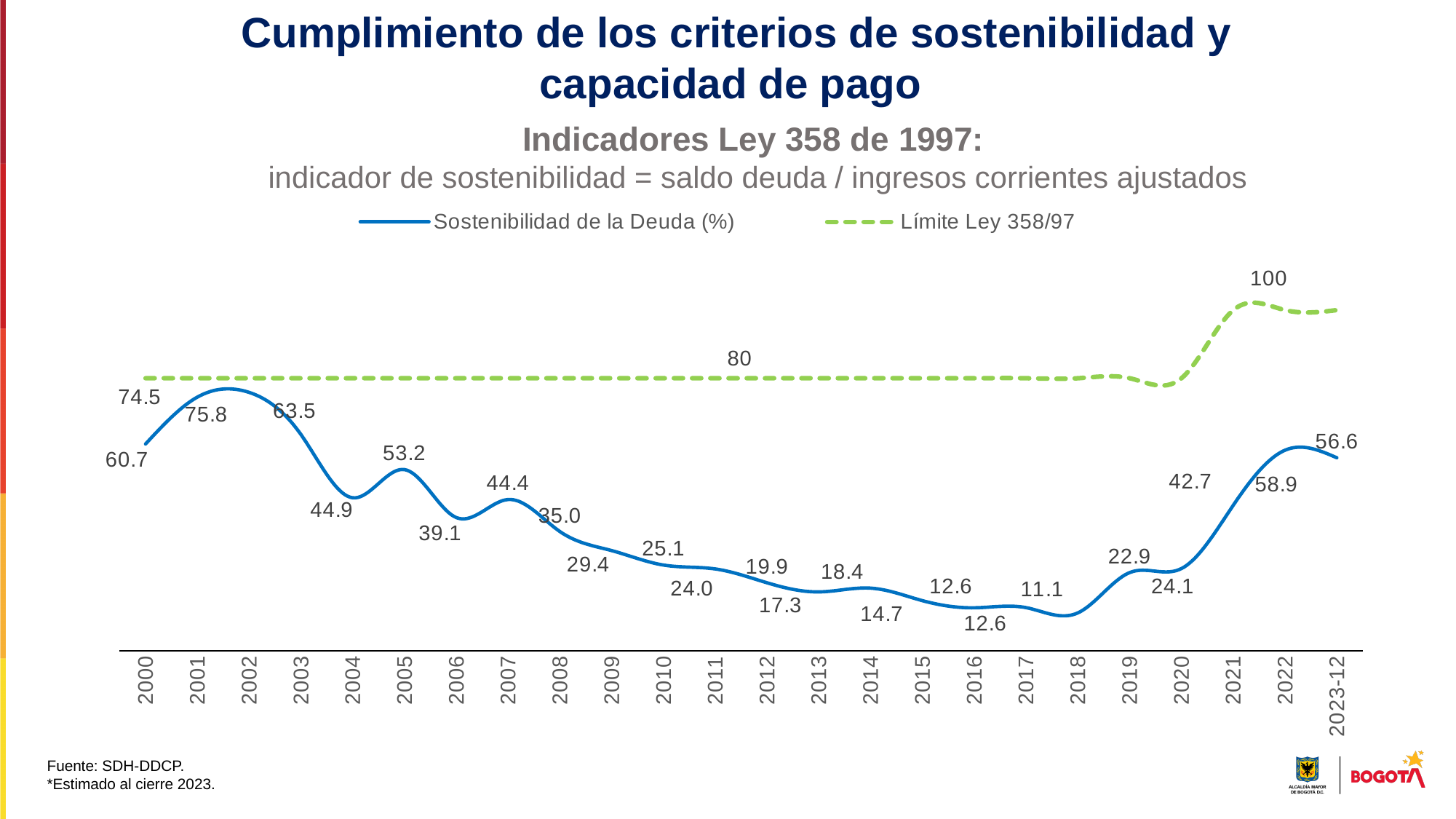
What is the value of the Límite Ley 358/97 line from 2021 onward? 100 What is the highest value reached by the Sostenibilidad de la Deuda (%) line? 75.8 What is the value of Sostenibilidad de la Deuda (%) in 2000? 60.7 How many years (points) are shown on the x axis? 24 What type of chart is shown on the slide? line chart Does the Sostenibilidad de la Deuda (%) line rise or fall between 2008 and 2018? fall How many series does the legend list? 2 Which is larger, the Sostenibilidad de la Deuda (%) value in 2000 or in 2023-12? 2000 What is the difference between the Sostenibilidad de la Deuda (%) values for 2022 and 2023-12? 2.3 What is the value of Sostenibilidad de la Deuda (%) for 2023-12? 56.6 What is the value of Sostenibilidad de la Deuda (%) in 2005? 53.2 In which year does the Sostenibilidad de la Deuda (%) line reach its lowest value? 2018